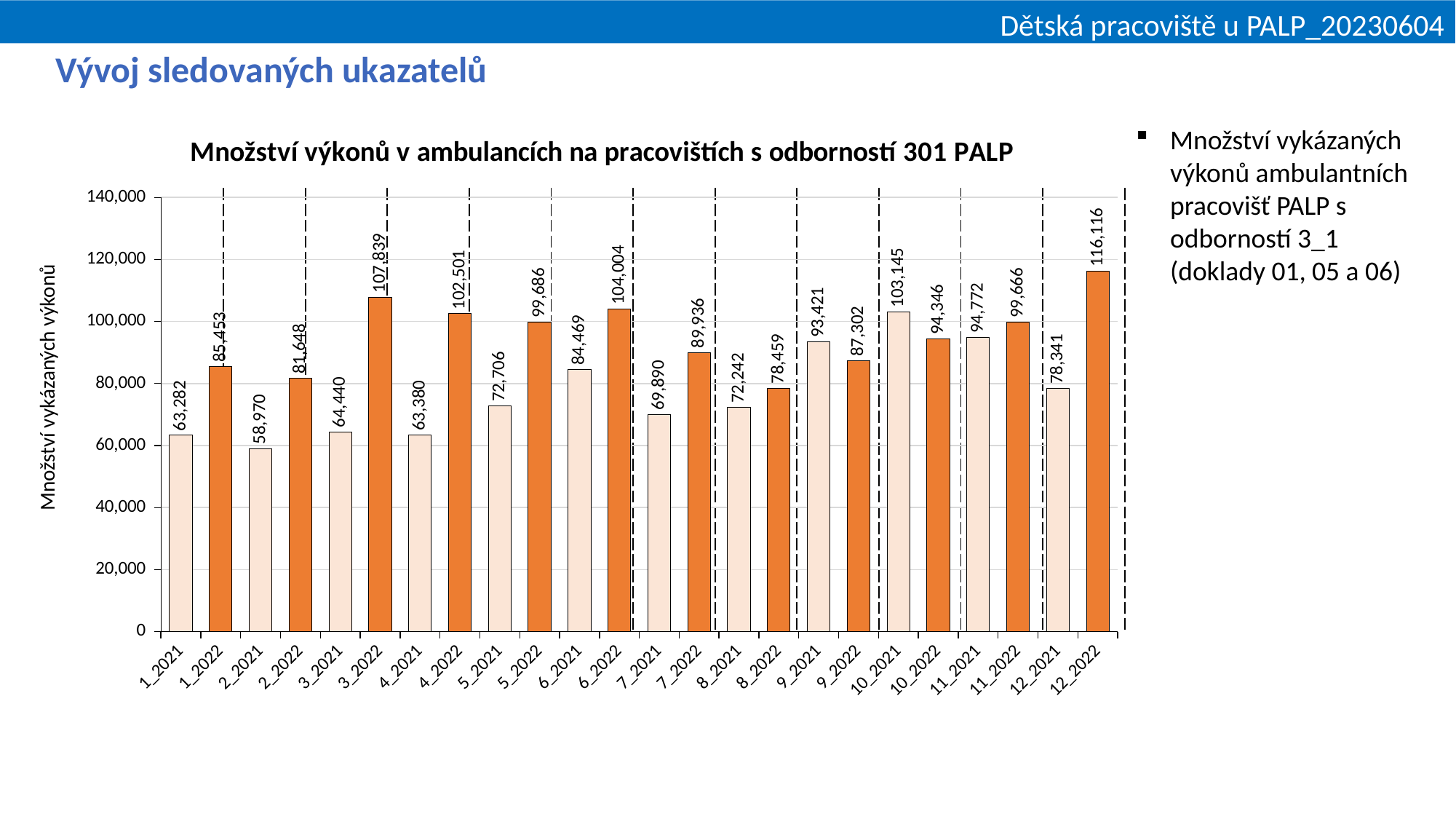
What is the value for 3_2022? 107,839 How many bars are shown in the chart? 24 What kind of chart is shown on the slide? bar chart What is the title of the chart? Množství výkonů v ambulancích na pracovištích s odborností 301 PALP Which is larger, the value for 10_2021 or the value for 10_2022? 10_2021 Is the value for 6_2022 greater or less than 100,000? greater Which category has the lowest value? 2_2021 Which category has the highest value? 12_2022 What is the value for 7_2021? 69,890 What is the difference between the values for 3_2022 and 3_2021? 43,399 What is the value for 9_2021? 93,421 What is the difference between the values for 12_2022 and 12_2021? 37,775